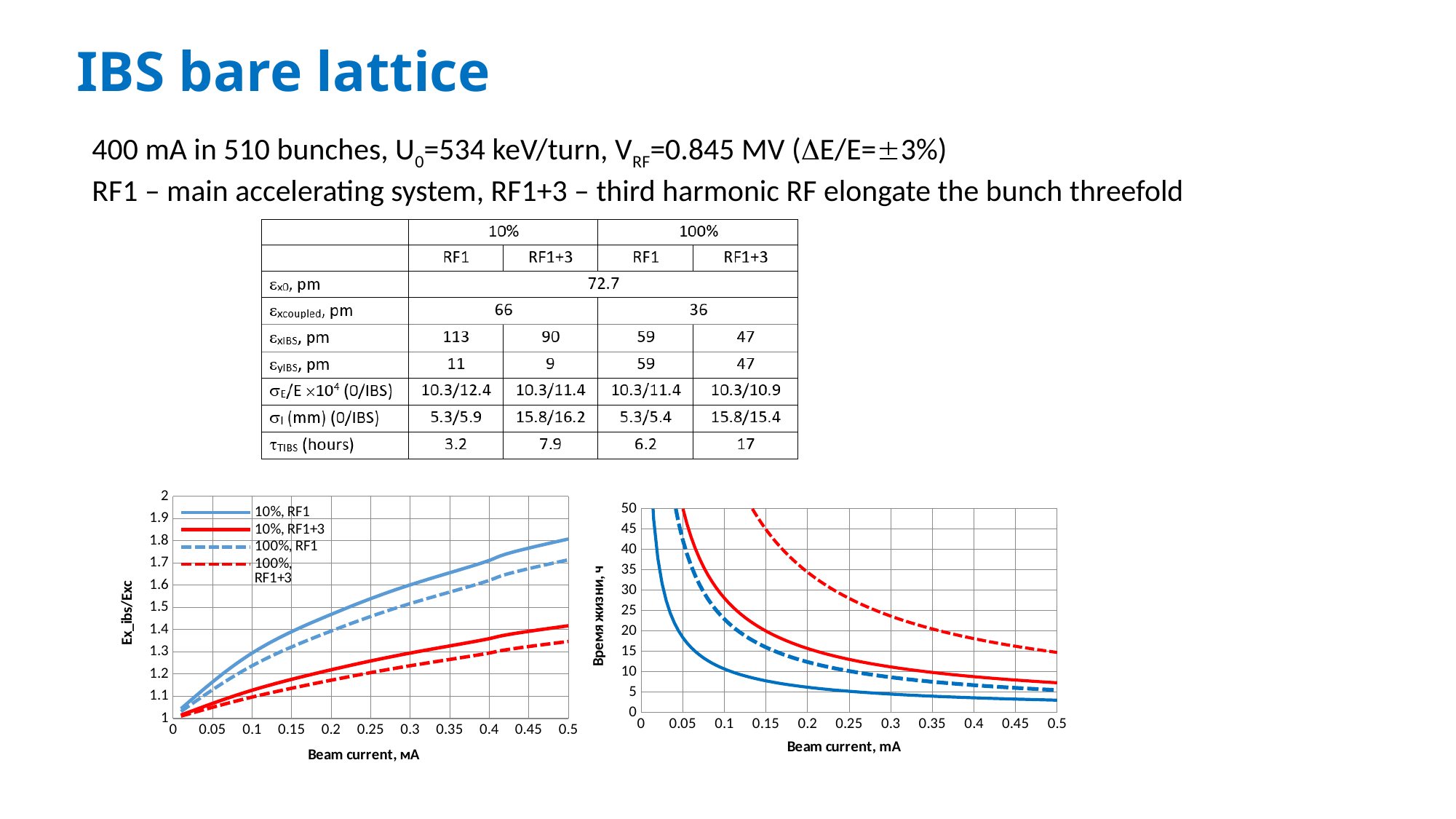
In the right chart, is the value of the dashed red line at 0.5 mA greater or less than 10? greater What kind of chart is the left chart (Ex_ibs/Exc vs Beam current)? line chart In the left chart, does Ex_ibs/Exc rise or fall as beam current increases? rise In the left chart, which series has the lowest value at 0.5 mA? 100%, RF1+3 In the right chart (Время жизни vs Beam current), do the values rise or fall as beam current increases? fall How many series does the legend of the left chart list? 4 In the left chart, is the value of the 100%, RF1+3 series at 0.5 mA greater or less than 1.5? less In the right chart, is the value of the solid blue line at 0.5 mA greater or less than 5? less In the left chart, at 0.3 mA, which is larger: the 10%, RF1 series or the 10%, RF1+3 series? 10%, RF1 What is the y-axis title of the left chart? Ex_ibs/Exc In the left chart, which series has the highest value at 0.5 mA? 10%, RF1